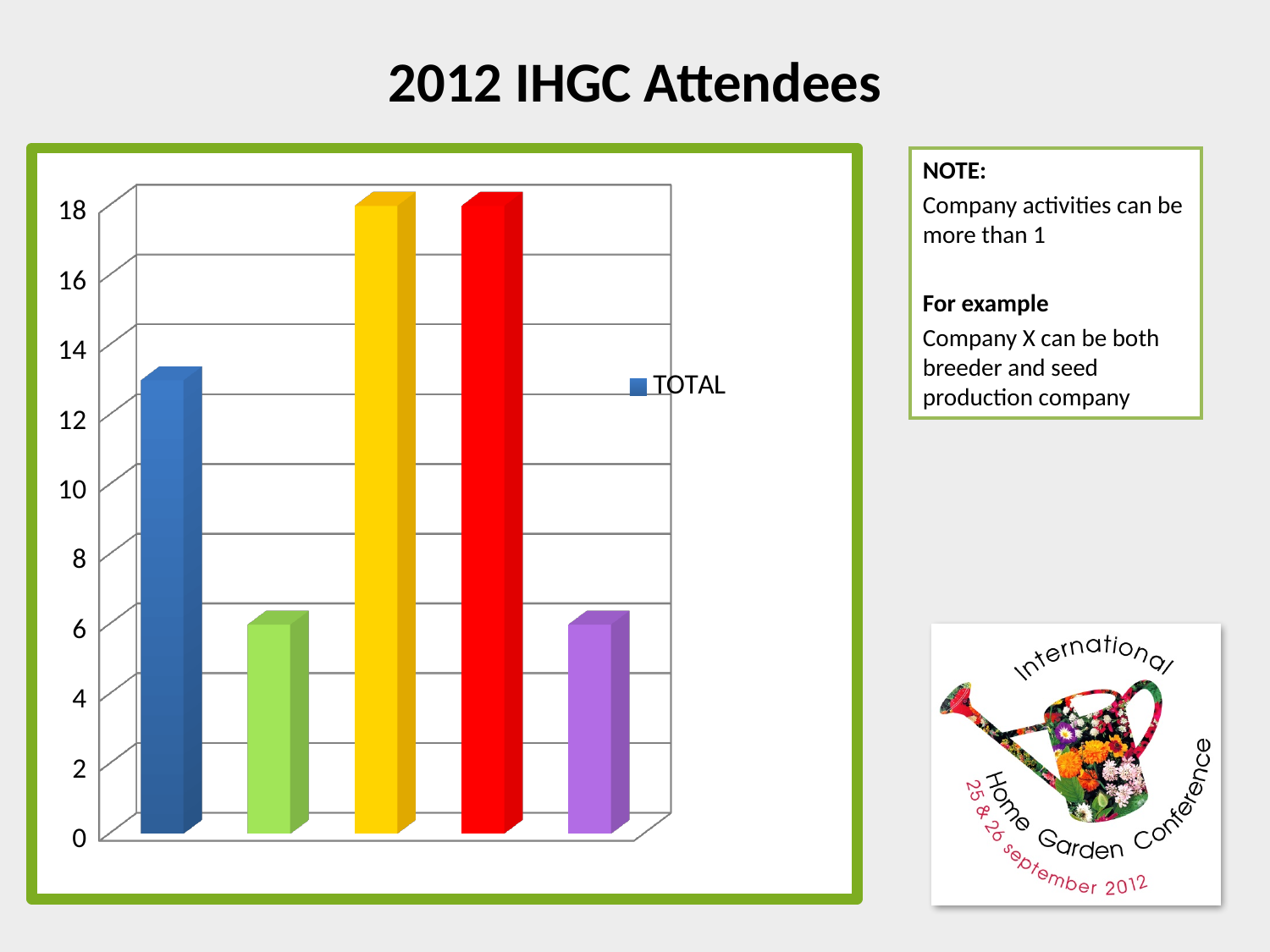
Is the value of the second (green) bar greater or less than 10? less What is the title of the slide containing the chart? 2012 IHGC Attendees Is the value of the fourth (red) bar greater or less than 14? greater What kind of chart is shown on the slide? bar chart How many bars are plotted in the chart? 5 Is the value of the third (yellow) bar greater or less than 16? greater Which bar is taller, the third (yellow) bar or the fifth (purple) bar? the yellow bar Which bar is taller, the first (blue) bar or the second (green) bar? the blue bar What is the name of the series shown in the chart legend? TOTAL How many series does the chart legend list? 1